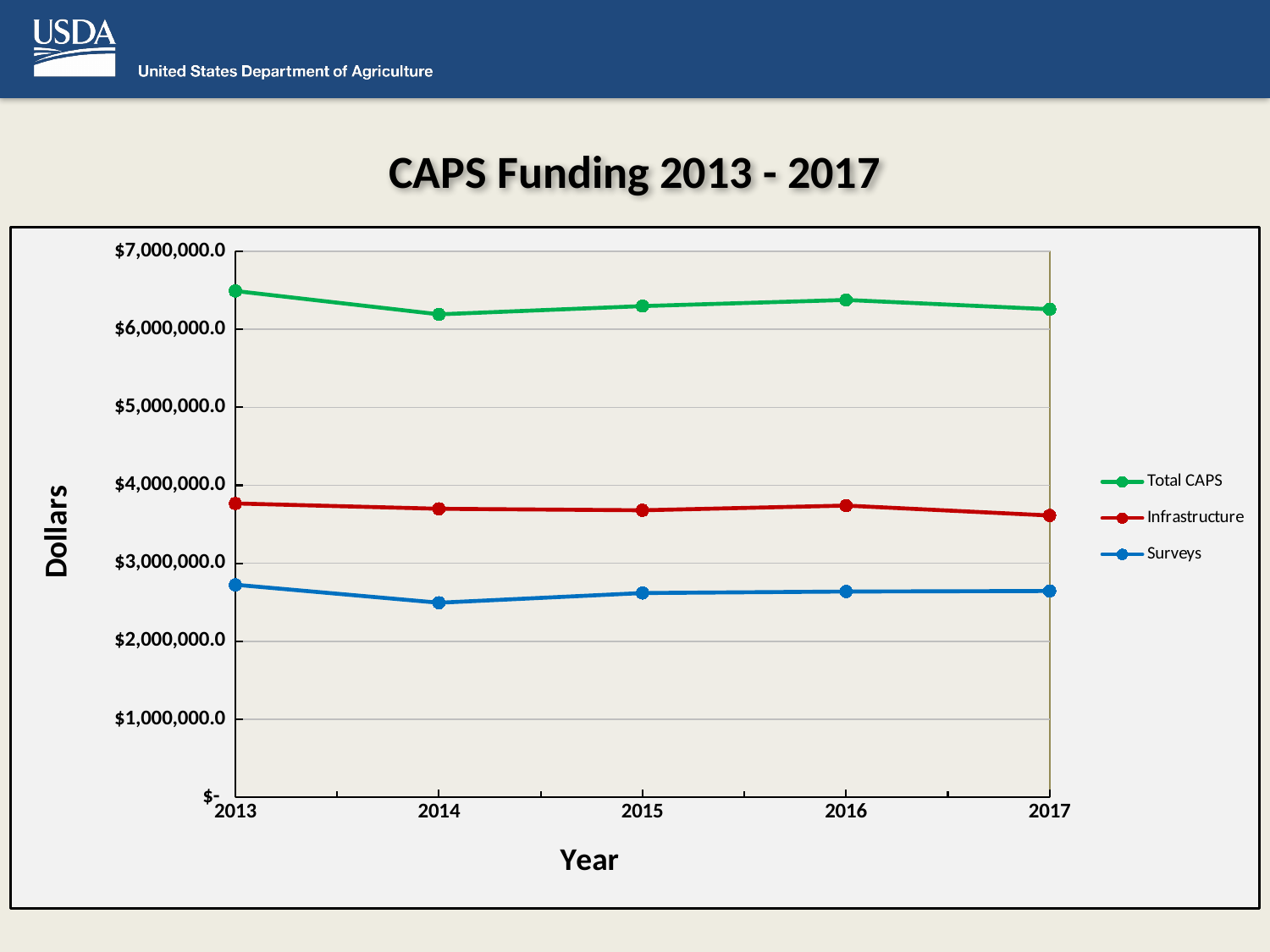
Is the value for Infrastructure in 2013 greater or less than $4,000,000.0? less What kind of chart is shown on the slide? line chart Is the value for Surveys in 2017 greater or less than $2,000,000.0? greater Is the value for Surveys in 2014 greater or less than $3,000,000.0? less In which year is the Surveys value lowest? 2014 How many series does the legend list? 3 How many years are plotted along the x axis? 5 Does the Total CAPS value rise or fall from 2013 to 2014? fall What is the title of the chart? CAPS Funding 2013 - 2017 In which year is the Surveys value highest? 2013 Which is larger in 2016, Infrastructure or Surveys? Infrastructure